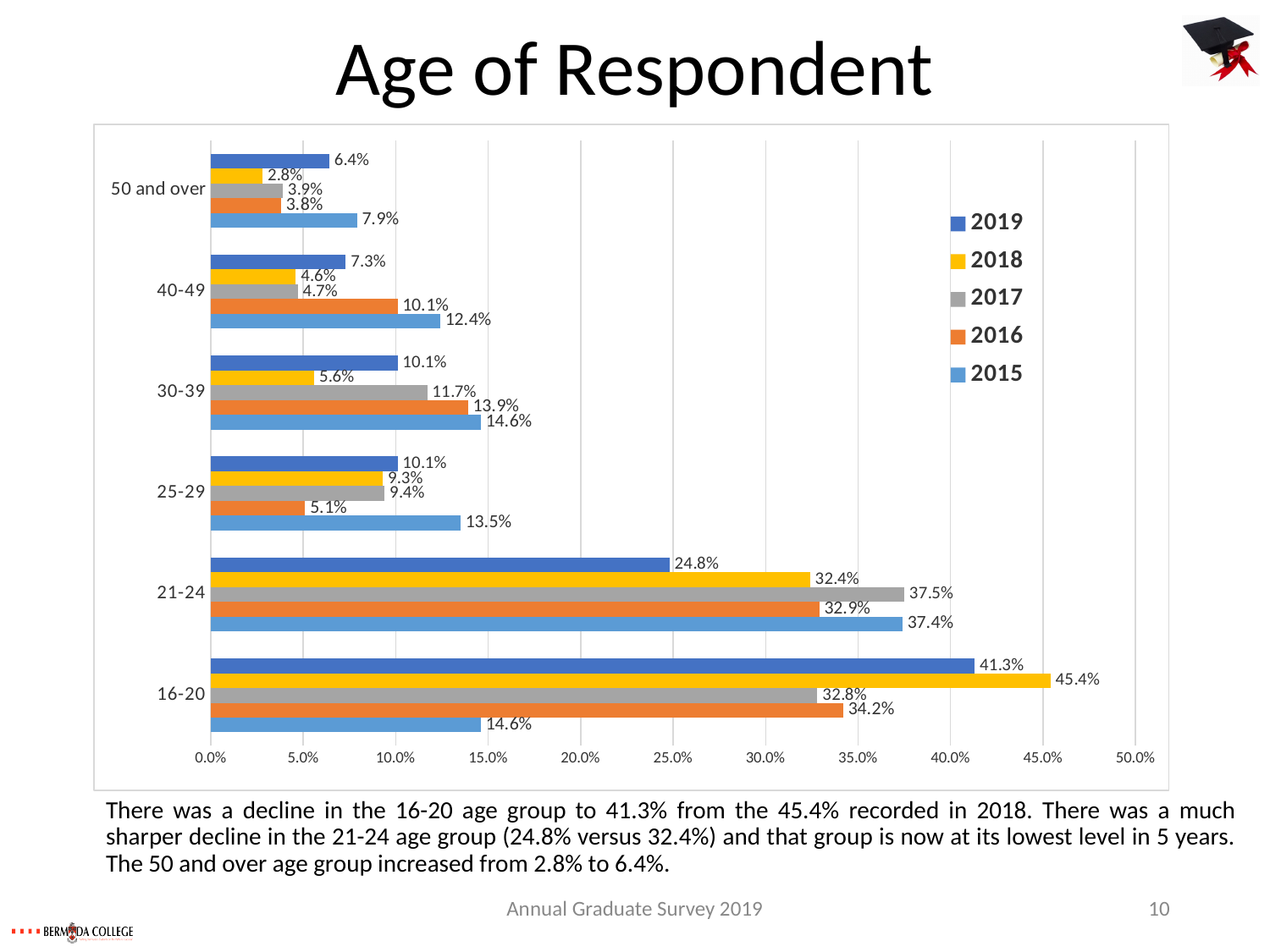
What is the 2015 value for the 40-49 age group? 12.4% Which age group has the highest 2019 value? 16-20 What is the difference between the 2018 and 2019 values for the 16-20 age group? 4.1% What kind of chart is shown on the slide? Bar chart How many age groups are shown on the chart? 6 What is the 2019 value for the 16-20 age group? 41.3% Which colour represents 2016 in the legend? Orange Which is larger for the 30-39 age group, the 2016 value or the 2017 value? 2016 Which age group has the lowest 2018 value? 50 and over What is the 2018 value for the 21-24 age group? 32.4% Is the 2017 value for the 21-24 age group greater or less than 35.0%? greater How many series does the legend list? 5